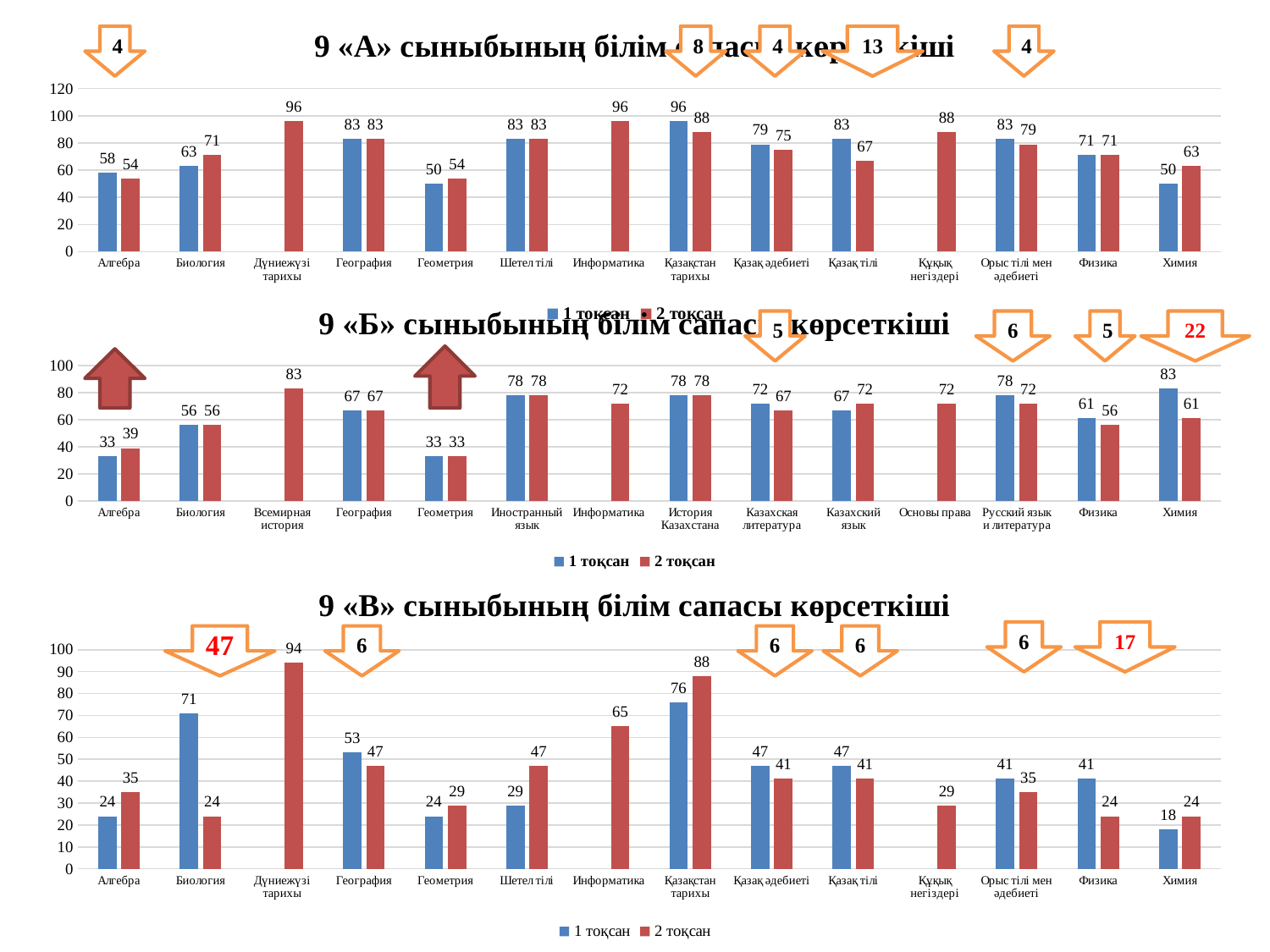
How many series does the legend of the bottom chart (9 «В») list? 2 In the middle chart (9 «Б»), what is the 2 тоқсан value for Всемирная история? 83 In the bottom chart (9 «В»), which category has the highest 2 тоқсан value? Дүниежүзі тарихы What kind of chart is the middle chart (9 «Б»)? Bar chart In the middle chart (9 «Б»), what is the difference between the 1 тоқсан and 2 тоқсан values for Химия? 22 In the bottom chart (9 «В»), what is the difference between the 1 тоқсан and 2 тоқсан values for Биология? 47 In the top chart (9 «А»), what is the value for Химия in 2 тоқсан? 63 In the top chart (9 «А»), what is the value for Алгебра in 1 тоқсан? 58 In the bottom chart (9 «В»), what is the 1 тоқсан value for Биология? 71 In the top chart (9 «А»), which category has the lowest 1 тоқсан value? Геометрия and Химия (both 50) In the middle chart (9 «Б»), which is larger for Химия: the 1 тоқсан value or the 2 тоқсан value? 1 тоқсан In the top chart (9 «А»), what is the difference between the 1 тоқсан and 2 тоқсан values for Қазақ тілі? 16